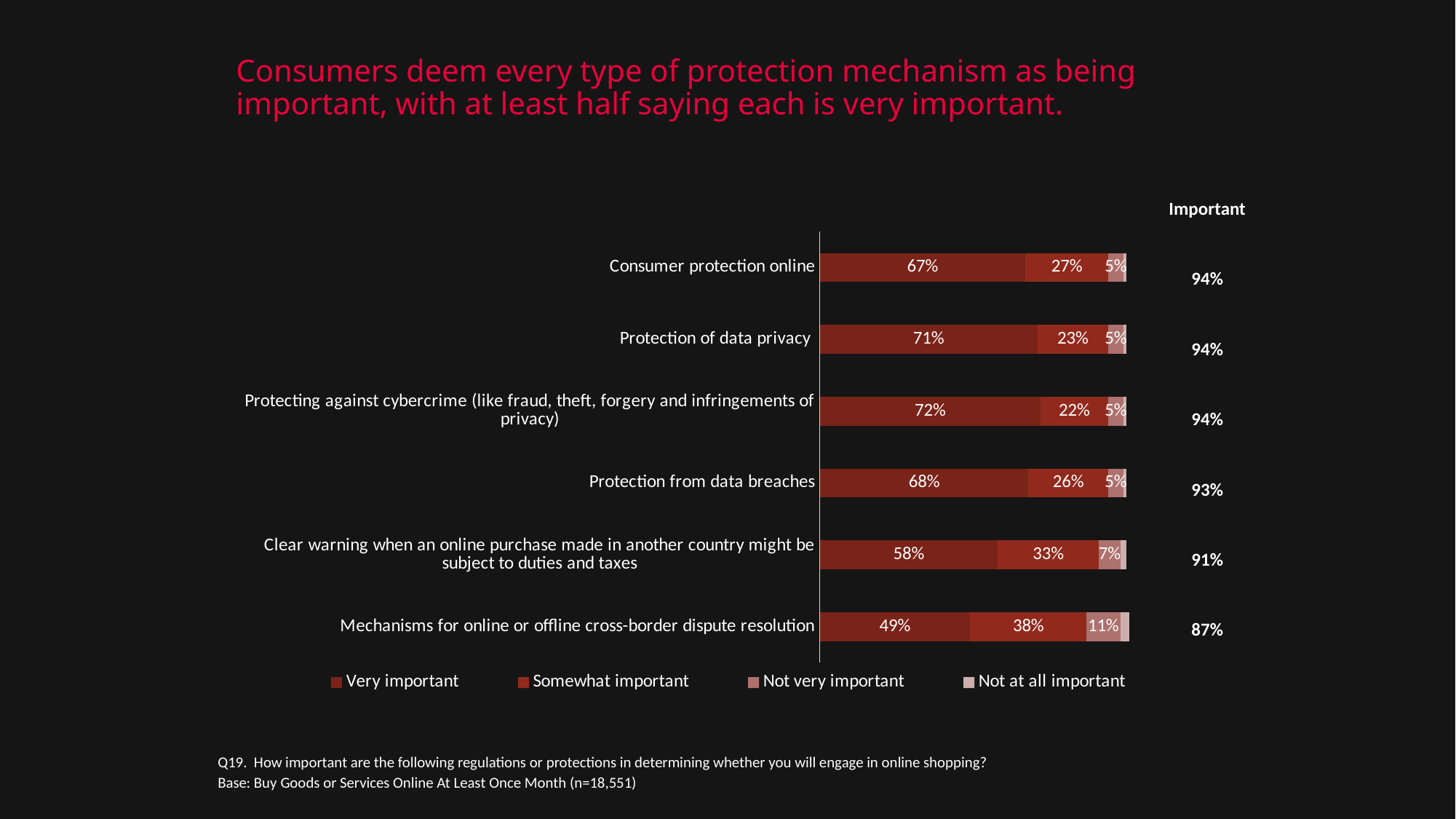
What is the 'Important' figure shown for 'Protection from data breaches'? 93% What is the first entry in the chart's legend? Very important Which category has the lowest 'Very important' percentage? Mechanisms for online or offline cross-border dispute resolution What kind of chart is shown on the slide? Stacked bar chart Which category has the highest 'Very important' percentage? Protecting against cybercrime (like fraud, theft, forgery and infringements of privacy) Which has a larger 'Somewhat important' share: 'Protection from data breaches' or 'Protection of data privacy'? Protection from data breaches How many protection mechanisms (categories) are shown in the chart? 6 What is the difference in 'Very important' percentage between 'Protection of data privacy' and 'Consumer protection online'? 4 percentage points What is the 'Not very important' value for 'Clear warning when an online purchase made in another country might be subject to duties and taxes'? 7% How many series does the legend list? 4 What percentage rated 'Mechanisms for online or offline cross-border dispute resolution' as somewhat important? 38% What percentage of respondents rated 'Consumer protection online' as very important? 67%